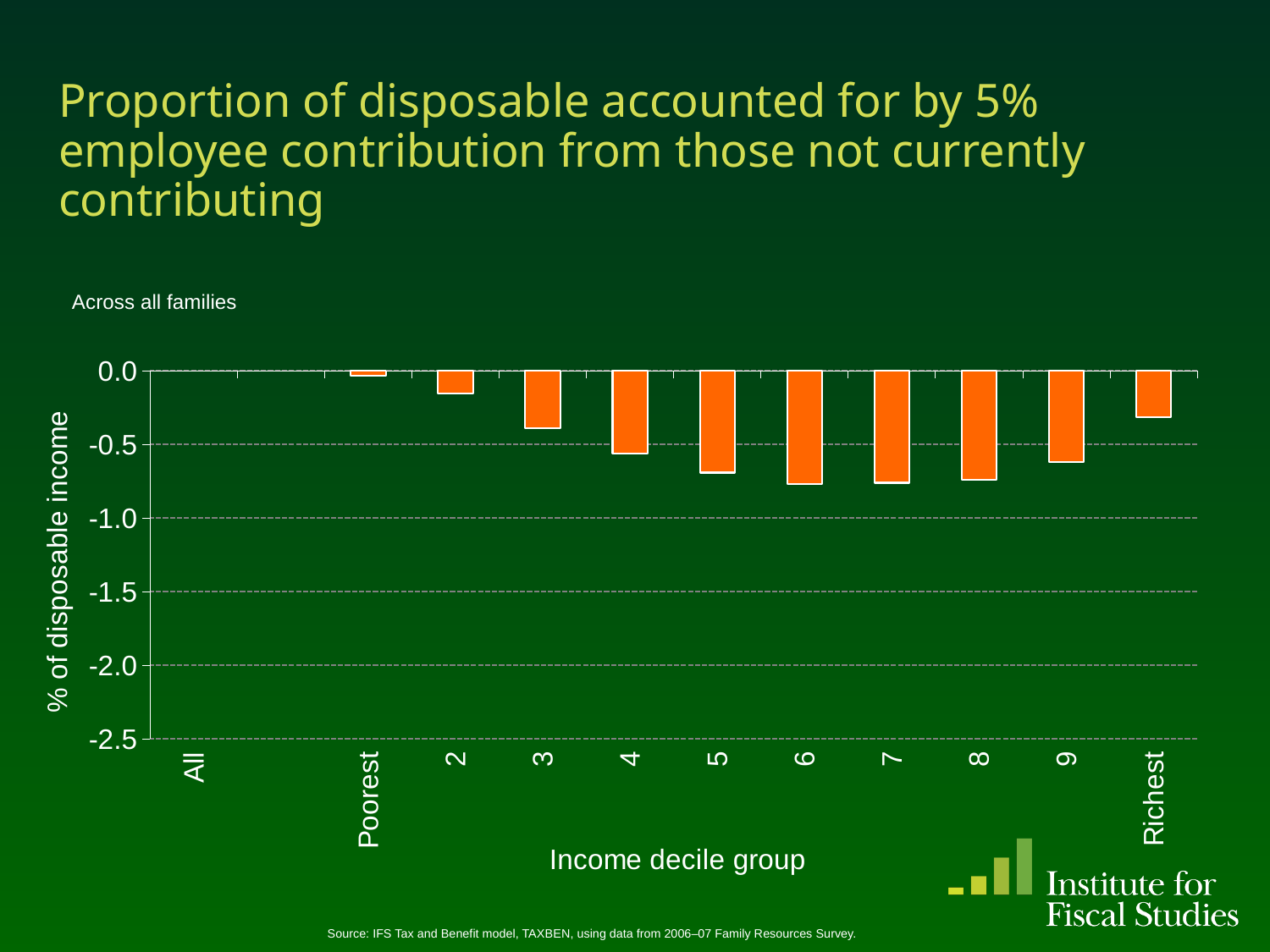
Is the value for the Richest decile group greater or less than -0.5? greater Which income decile group has the bar closest to zero (the smallest reduction in disposable income)? Poorest What is the label on the x axis of the chart? Income decile group What kind of chart is shown on the slide? bar chart Is the value for income decile group 3 greater or less than -0.5? greater Is the value for income decile group 7 greater or less than -1.0? greater Which bar extends further below zero: decile group 3 or decile group 6? 6 How many income decile group categories are labelled on the x axis? 11 Moving from the Poorest decile group to decile group 6, do the values rise or fall? fall What is the label on the y axis of the chart? % of disposable income